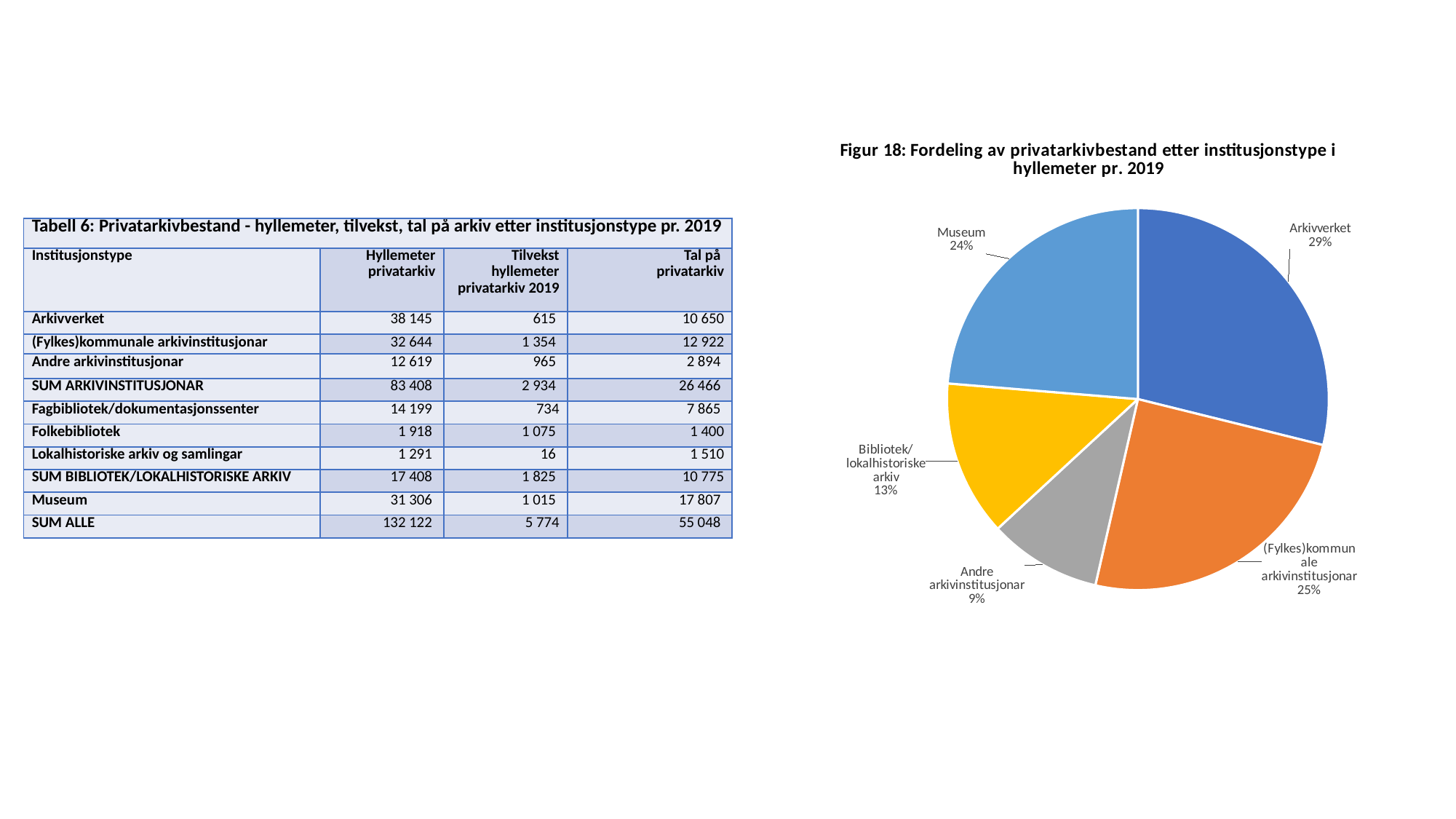
How many slices does the pie chart have? 5 In the pie chart, how many percentage points larger is Arkivverket's share than Museum's share? 5 In the pie chart, what share does Bibliotek/lokalhistoriske arkiv have? 13% In the pie chart, what share does Andre arkivinstitusjonar have? 9% In the pie chart, what share does Arkivverket have? 29% Which slice of the pie chart is the smallest? Andre arkivinstitusjonar What kind of chart is Figur 18? pie chart Which slice of the pie chart is the largest? Arkivverket What is the title of the pie chart? Figur 18: Fordeling av privatarkivbestand etter institusjonstype i hyllemeter pr. 2019 In the pie chart, which has the larger share: Museum or Bibliotek/lokalhistoriske arkiv? Museum